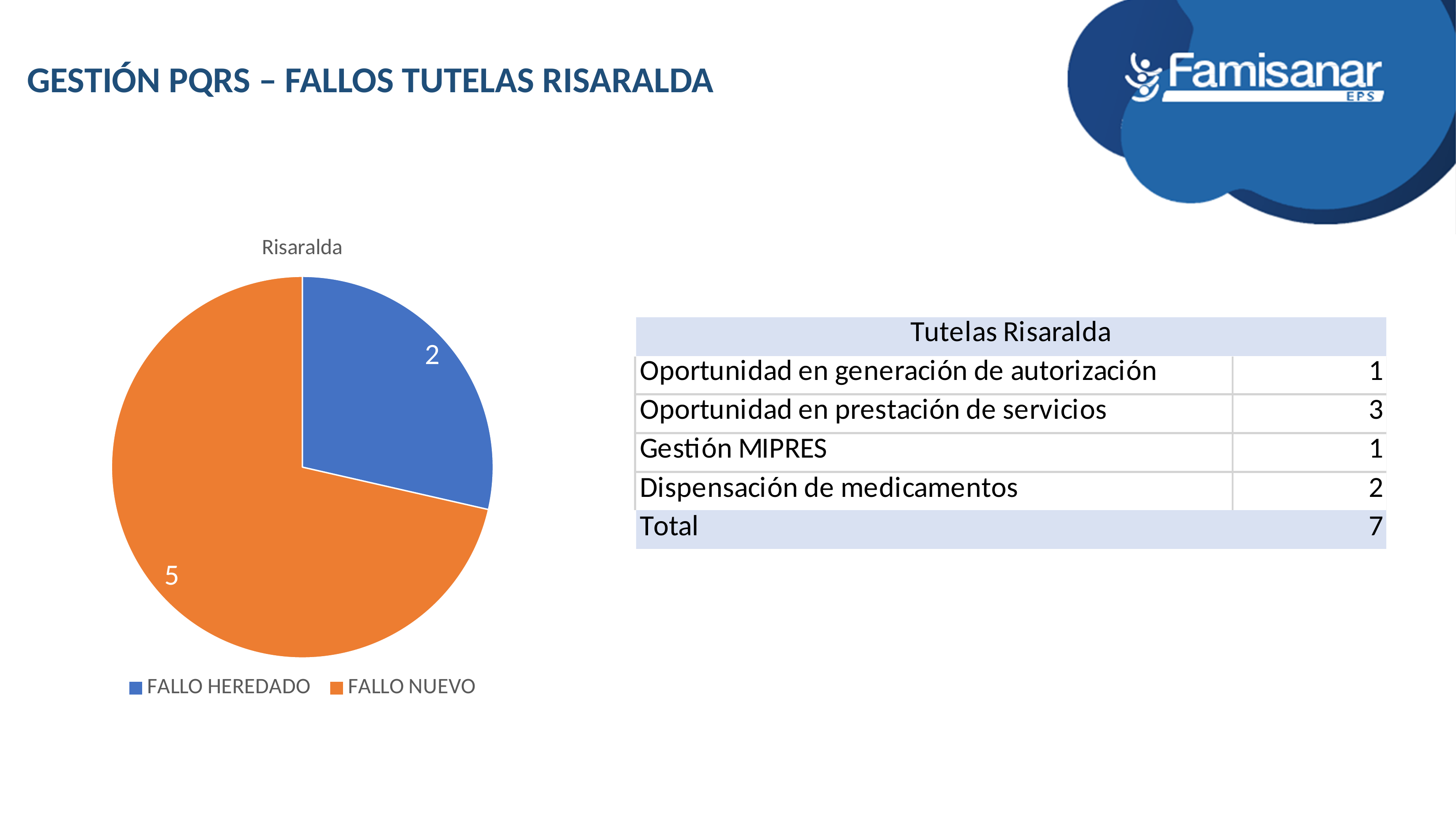
Which slice is the largest in the Risaralda pie chart? FALLO NUEVO How many entries does the legend of the Risaralda chart list? 2 What is the value for FALLO NUEVO in the Risaralda pie chart? 5 What is the title of the pie chart? Risaralda Which slice is the smallest in the Risaralda pie chart? FALLO HEREDADO What colour is the FALLO NUEVO slice in the Risaralda pie chart? Orange How many slices does the Risaralda pie chart have? 2 What kind of chart is shown on the slide? Pie chart What is the difference between FALLO NUEVO and FALLO HEREDADO in the Risaralda pie chart? 3 What is the value for FALLO HEREDADO in the Risaralda pie chart? 2 Which is larger in the Risaralda pie chart, FALLO HEREDADO or FALLO NUEVO? FALLO NUEVO What is the total of all slices in the Risaralda pie chart? 7